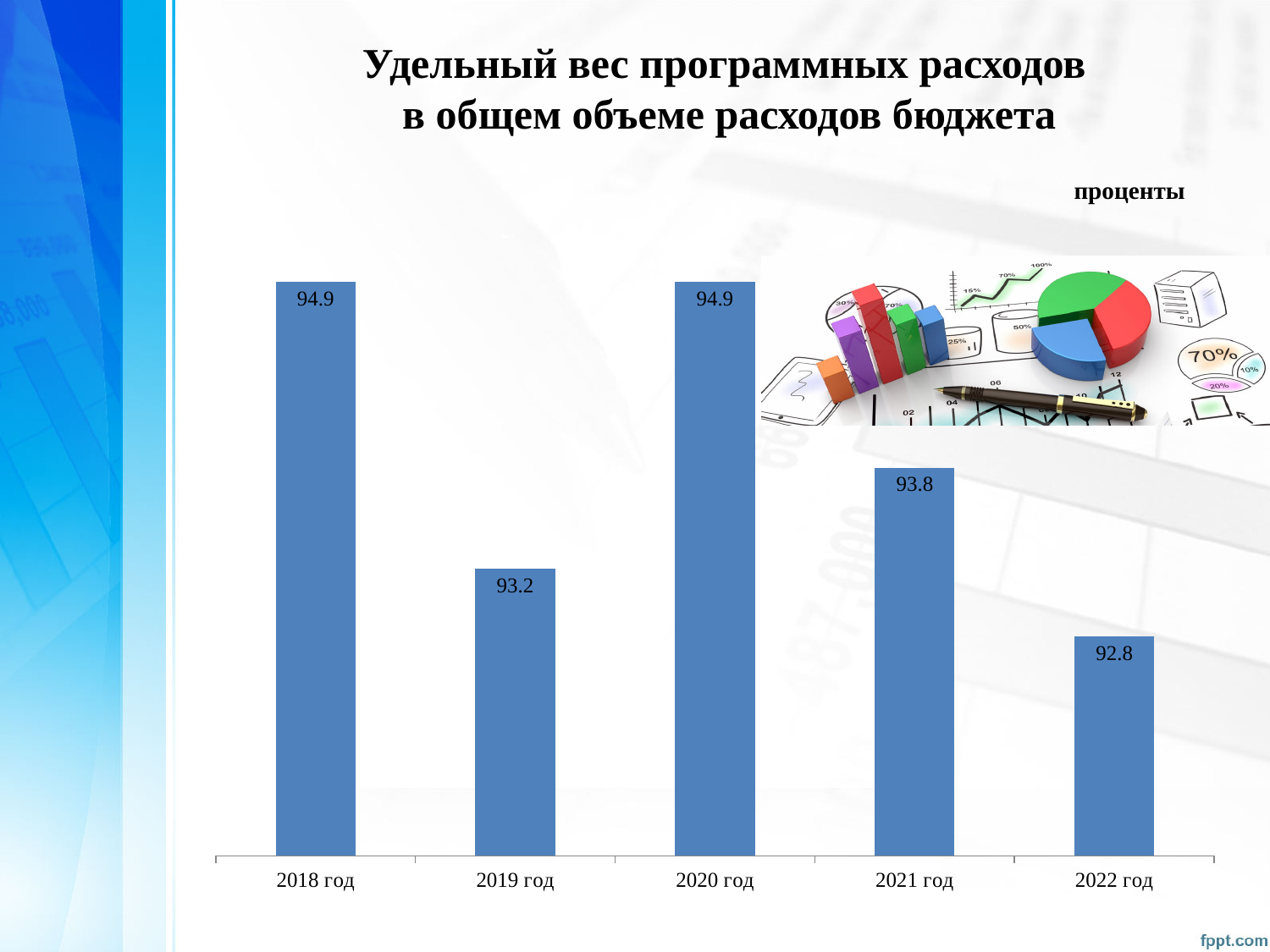
What unit of measurement is indicated for the chart? проценты What is the value for 2019 год? 93.2 What is the difference between the values for 2021 год and 2019 год? 0.6 What is the value for 2021 год? 93.8 Which year has the lowest value? 2022 год How many years are shown in the chart? 5 What is the value for 2018 год? 94.9 What is the value for 2022 год? 92.8 What kind of chart is shown on the slide? Bar chart What is the difference between the values for 2020 год and 2022 год? 2.1 Which is larger, the value for 2019 год or the value for 2021 год? 2021 год What is the highest value shown in the chart? 94.9